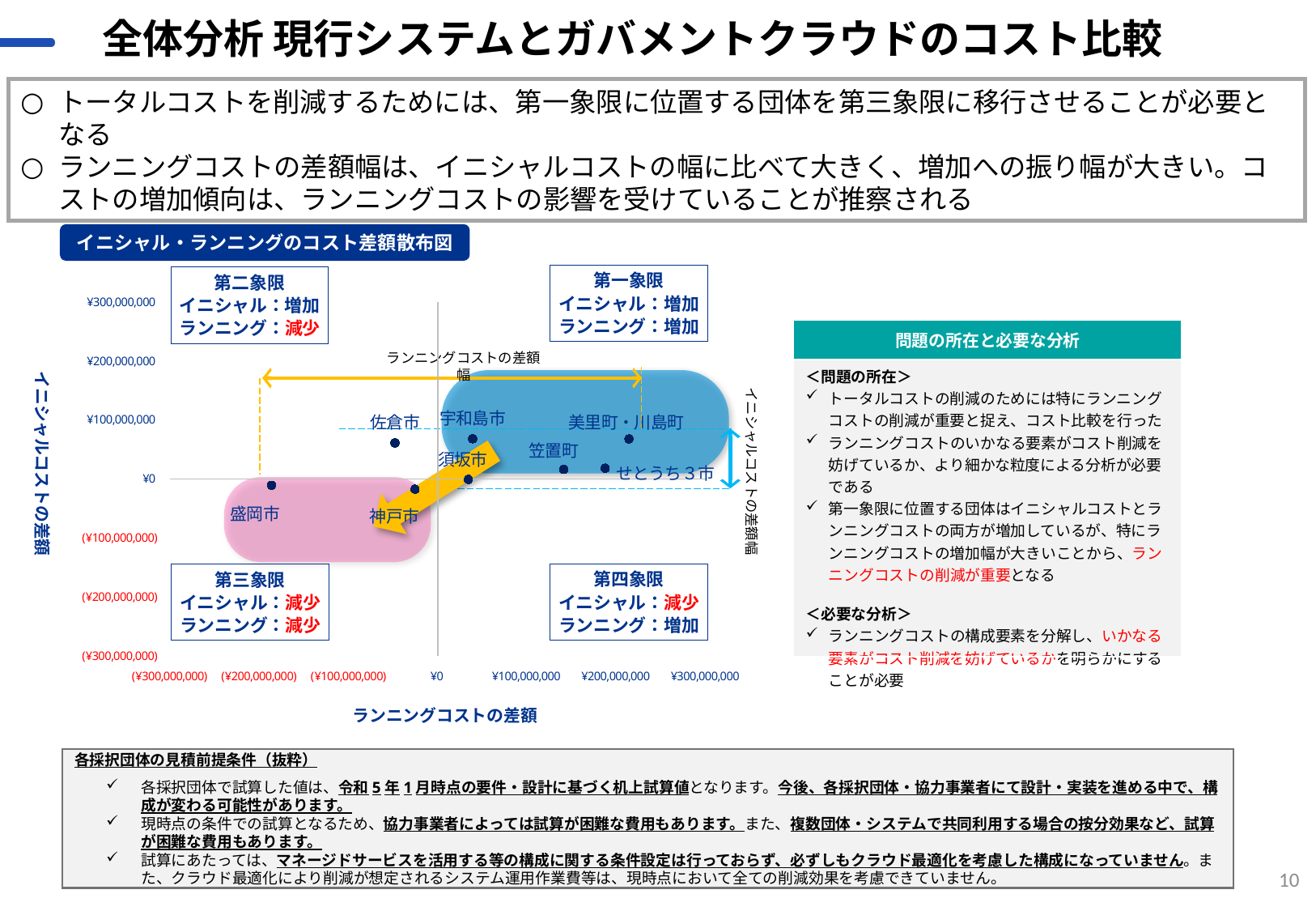
What is the title of the chart on the slide? イニシャル・ランニングのコスト差額散布図 Is the running cost difference for せとうち３市 greater or less than ¥100,000,000? greater Is the initial cost difference for 宇和島市 greater or less than ¥0? greater Which has the larger running cost difference, 美里町・川島町 or 盛岡市? 美里町・川島町 What is the label of the horizontal axis of the scatter chart? ランニングコストの差額 Which municipality has the lowest running cost difference (furthest left on the x axis)? 盛岡市 Is the running cost difference for 美里町・川島町 greater or less than ¥100,000,000? greater Which has the larger running cost difference, 笠置町 or 佐倉市? 笠置町 What kind of chart is shown on the slide? Scatter chart How many municipalities (data points) are plotted on the scatter chart? 8